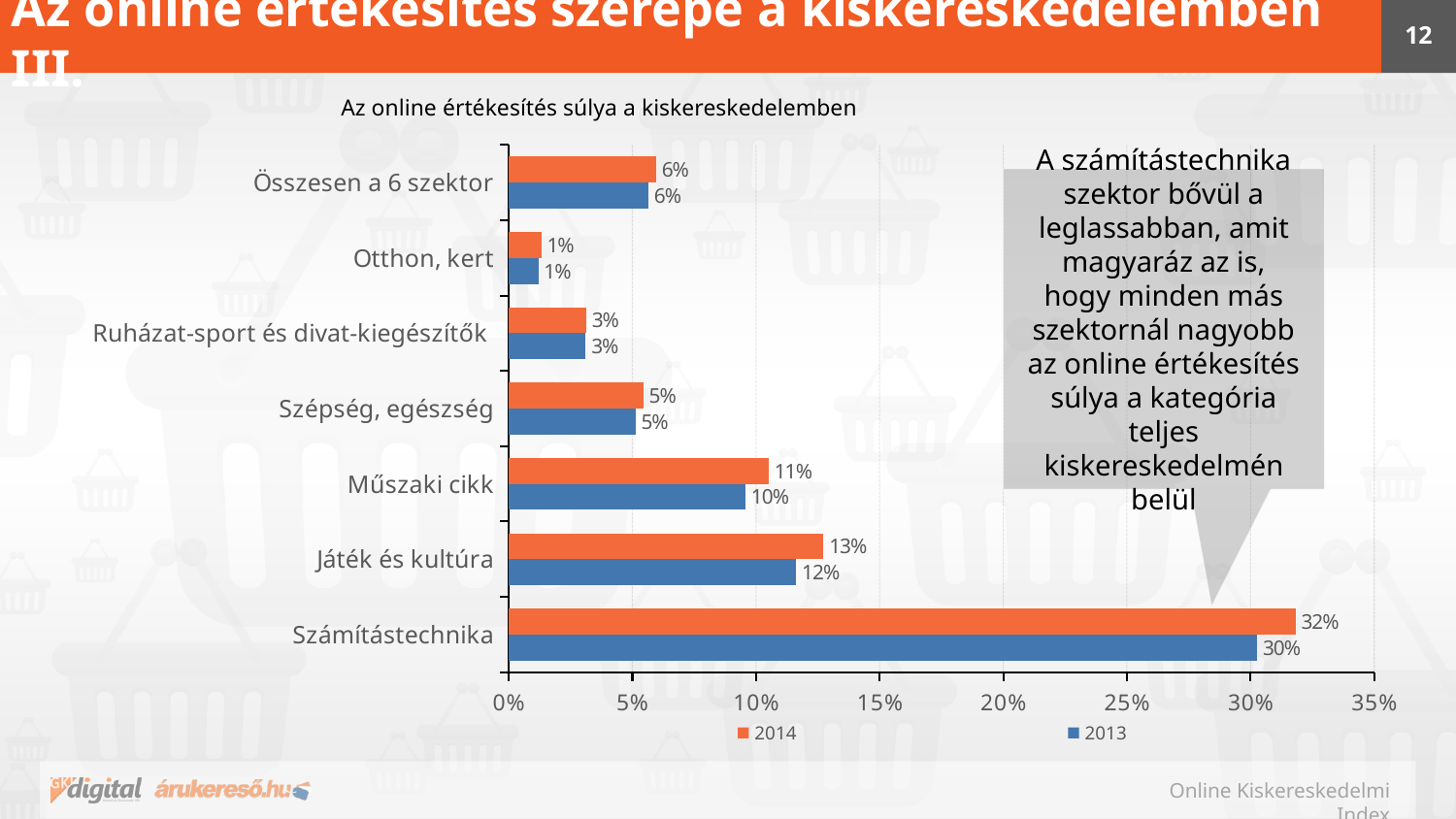
What is the 2014 value for Számítástechnika? 32% What type of chart is shown on the slide? Bar chart Which category has the highest 2014 value? Számítástechnika How many series does the legend list? 2 Is the 2013 value for Számítástechnika greater or less than 25%? greater What is the 2014 value for Műszaki cikk? 11% What is the 2013 value for Otthon, kert? 1% What is the 2013 value for Játék és kultúra? 12% Which is larger for Játék és kultúra, the 2014 value or the 2013 value? 2014 What is the difference between the 2014 and 2013 values for Számítástechnika? 2% Which category has the lowest 2013 value? Otthon, kert How many categories are shown on the chart? 7